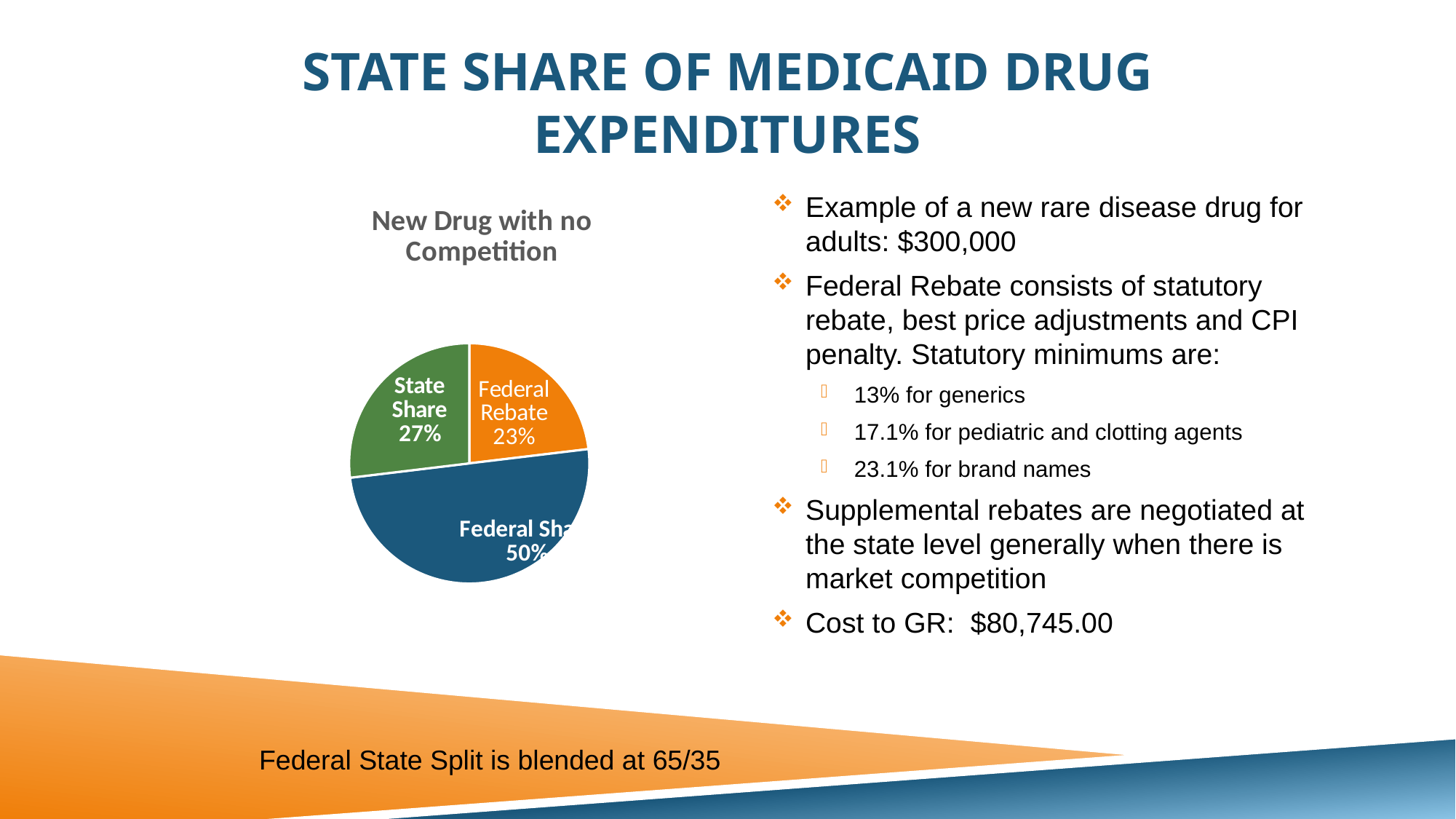
What is the difference in percentage points between Federal Share and State Share? 23 What share of the pie does Federal Rebate represent? 23% What is the title of the pie chart? New Drug with no Competition How many slices does the pie chart have? 3 What colour is the Federal Share slice? Blue Which slice of the pie is the largest? Federal Share What kind of chart is shown on the slide? Pie chart Which is larger, State Share or Federal Rebate? State Share What is the difference in percentage points between State Share and Federal Rebate? 4 Which slice of the pie is the smallest? Federal Rebate What share of the pie does State Share represent? 27% What share of the pie does Federal Share represent? 50%